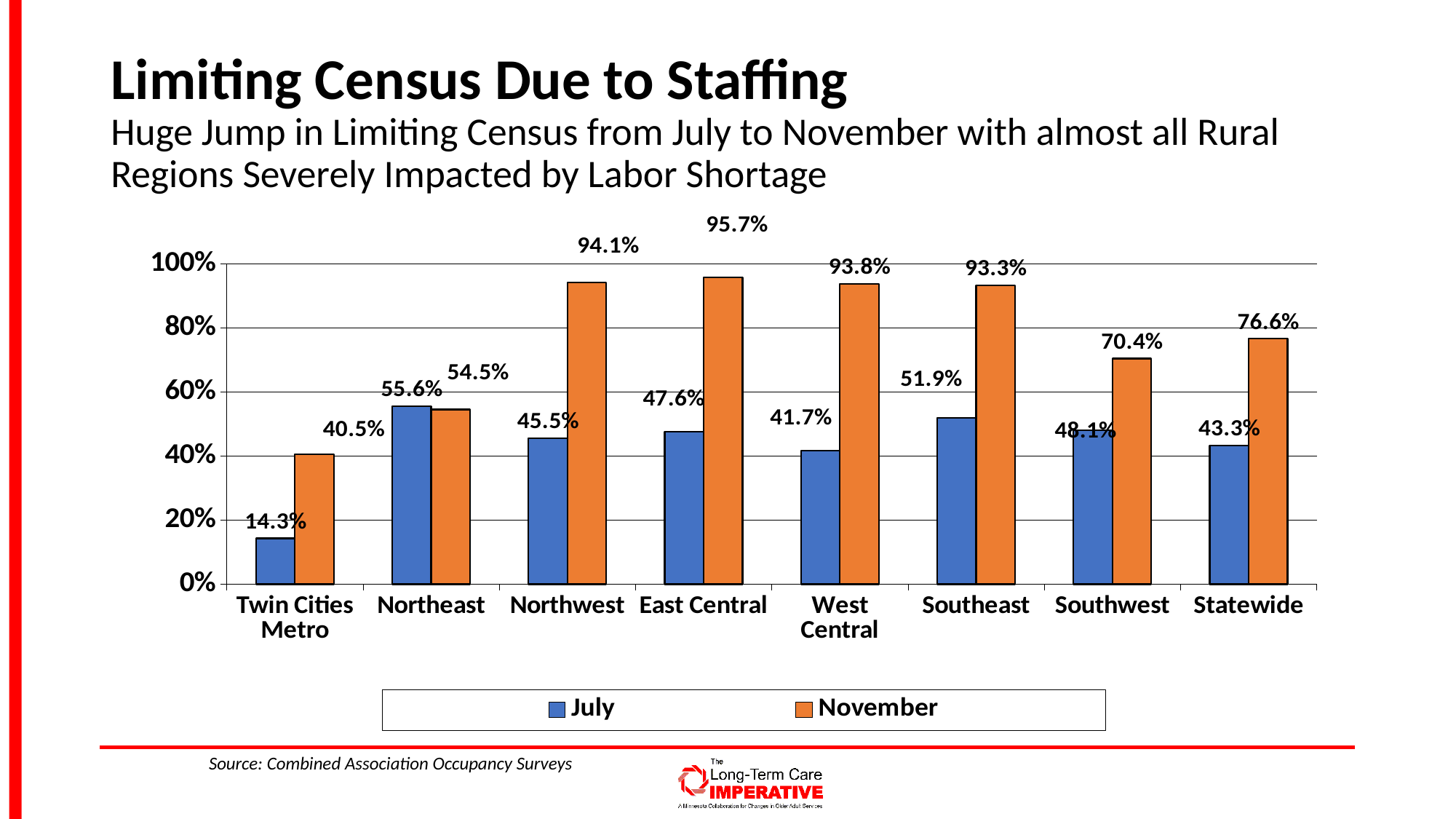
What is the November value for Southwest? 70.4% How many series does the legend list? 2 How many regions are shown on the x axis? 8 What is the difference between the November and July values for Statewide? 33.3% Which region has the highest November value? East Central What is the difference between the November and July values for Twin Cities Metro? 26.2% What kind of chart is shown on the slide? Bar chart Which region has the lowest July value? Twin Cities Metro What are the two series named in the legend? July and November For Northeast, which is larger, the July value or the November value? July What is the November value for Northwest? 94.1% What is the July value for Twin Cities Metro? 14.3%